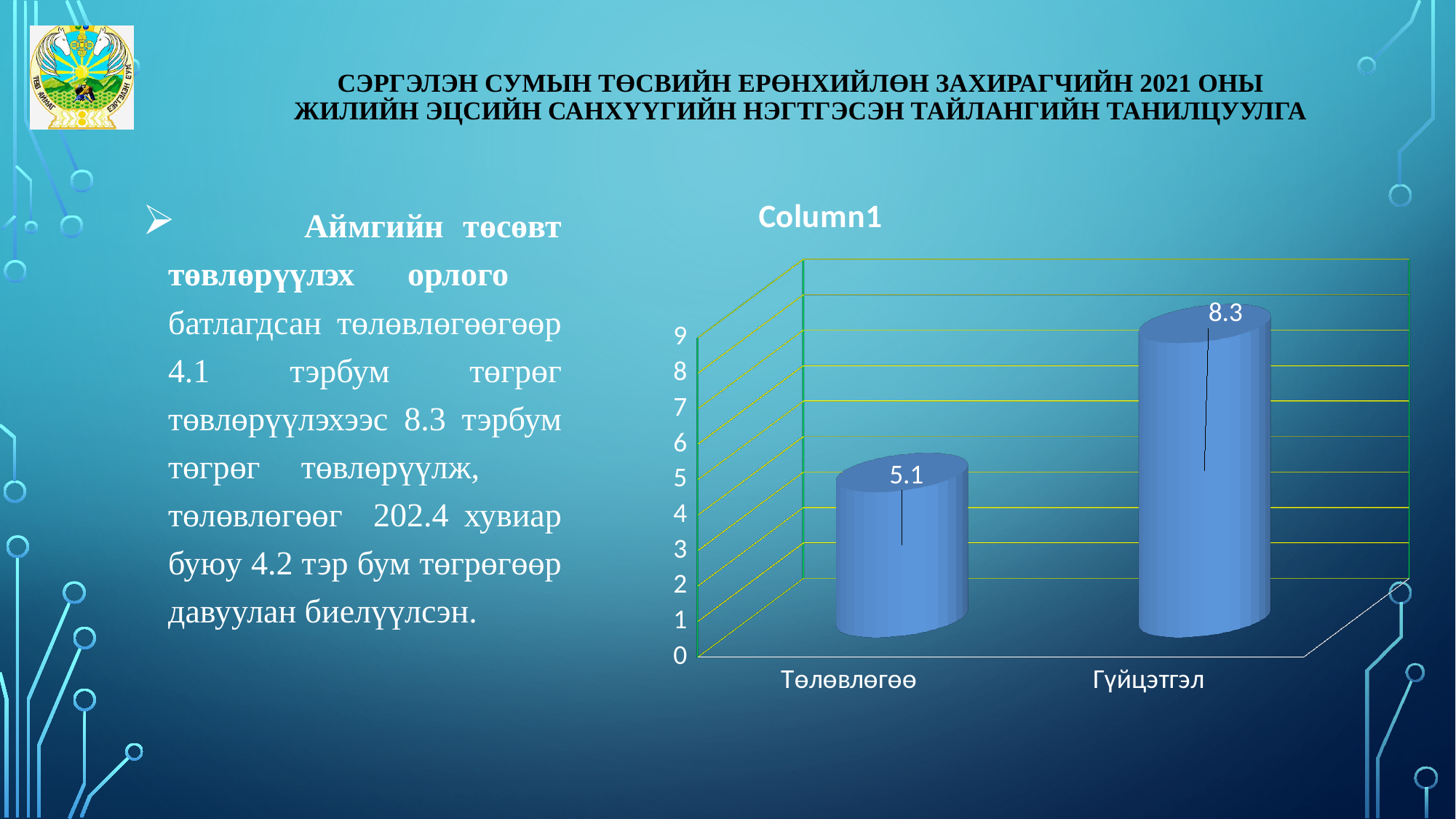
How many categories are shown in the chart? 2 What is the value for Гүйцэтгэл in the chart? 8.3 What is the title of the chart? Column1 Which category has the highest value in the chart? Гүйцэтгэл Is the value for Төлөвлөгөө greater or less than 6? less Which is larger, the value for Төлөвлөгөө or the value for Гүйцэтгэл? Гүйцэтгэл Which category has the lowest value in the chart? Төлөвлөгөө Is the value for Гүйцэтгэл greater or less than 7? greater What is the difference between the values for Гүйцэтгэл and Төлөвлөгөө? 3.2 What is the value for Төлөвлөгөө in the chart? 5.1 What kind of chart is shown on the slide? bar chart Do the values rise or fall from Төлөвлөгөө to Гүйцэтгэл? rise